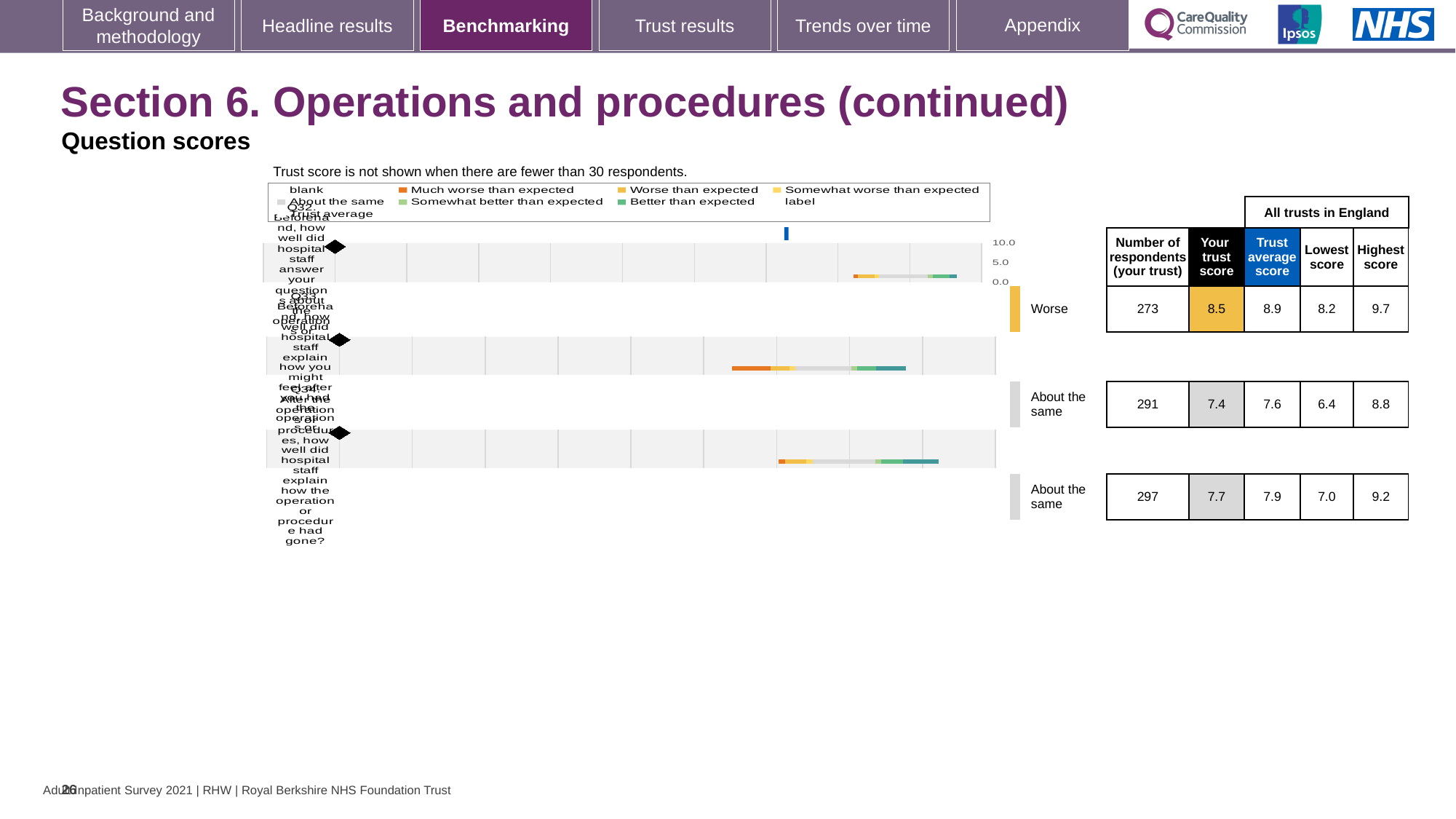
How many respondents are listed for the first row (Q32) in the table next to the chart? 273 What is the highest value shown on the chart's horizontal axis? 10.0 Is the 'Your trust score' for the first row (Q32) larger or smaller than the 'Trust average score' for that row? smaller What is the difference between the 'Highest score' and the 'Lowest score' for the first row (Q32) in the table next to the chart? 1.5 What kind of chart is used to show the benchmarking results on this slide? bar chart What is the 'Trust average score' for the third row in the table next to the chart? 7.9 In the table next to the chart, what is the 'Your trust score' for the second row? 7.4 In the table next to the chart, what is the 'Your trust score' for the third row? 7.7 Which row in the table next to the chart has the lowest 'Lowest score'? the second row What benchmark category label is shown for the first row (Q32) beside the chart? Worse Which row in the table next to the chart has the highest 'Your trust score'? the first row (Q32) In the table next to the chart, what is the 'Your trust score' for the first row (Q32)? 8.5